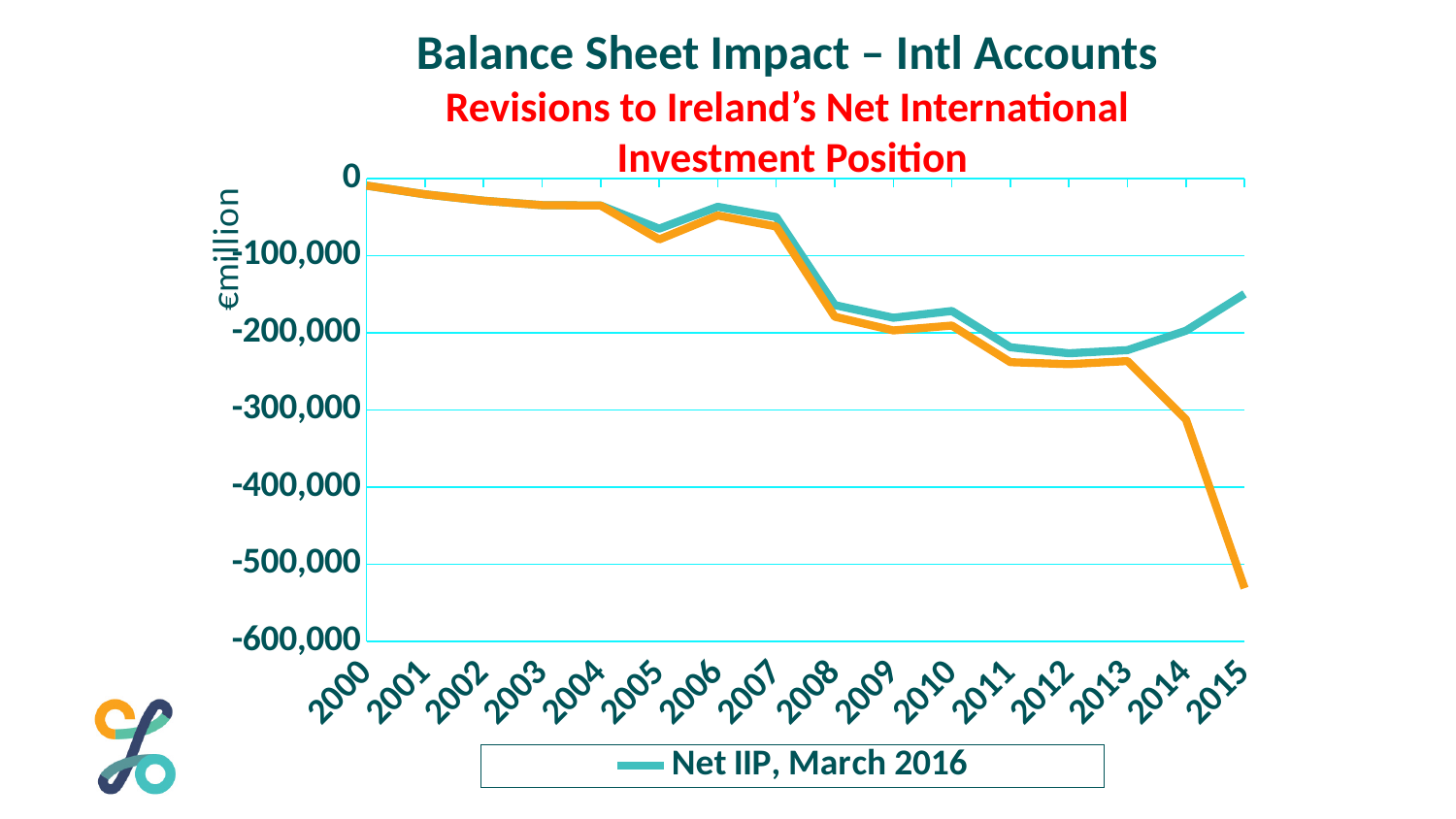
In 2015, which line has the higher value, the Net IIP, March 2016 line or the orange line? Net IIP, March 2016 What unit is shown on the chart's vertical axis label? €million How many years are shown along the x axis of the chart? 16 Is the value of the Net IIP, March 2016 line in 2015 greater or less than -200,000? greater In which year does the orange line reach its lowest value? 2015 Do the values of the Net IIP, March 2016 line generally rise or fall from 2000 to 2013? fall What is the name of the series listed in the chart's legend? Net IIP, March 2016 Is the value of the orange line in 2005 greater or less than -100,000? greater Is the value of the Net IIP, March 2016 line in 2012 greater or less than -200,000? less How many series does the chart's legend list? 1 What kind of chart is shown on the slide? line chart